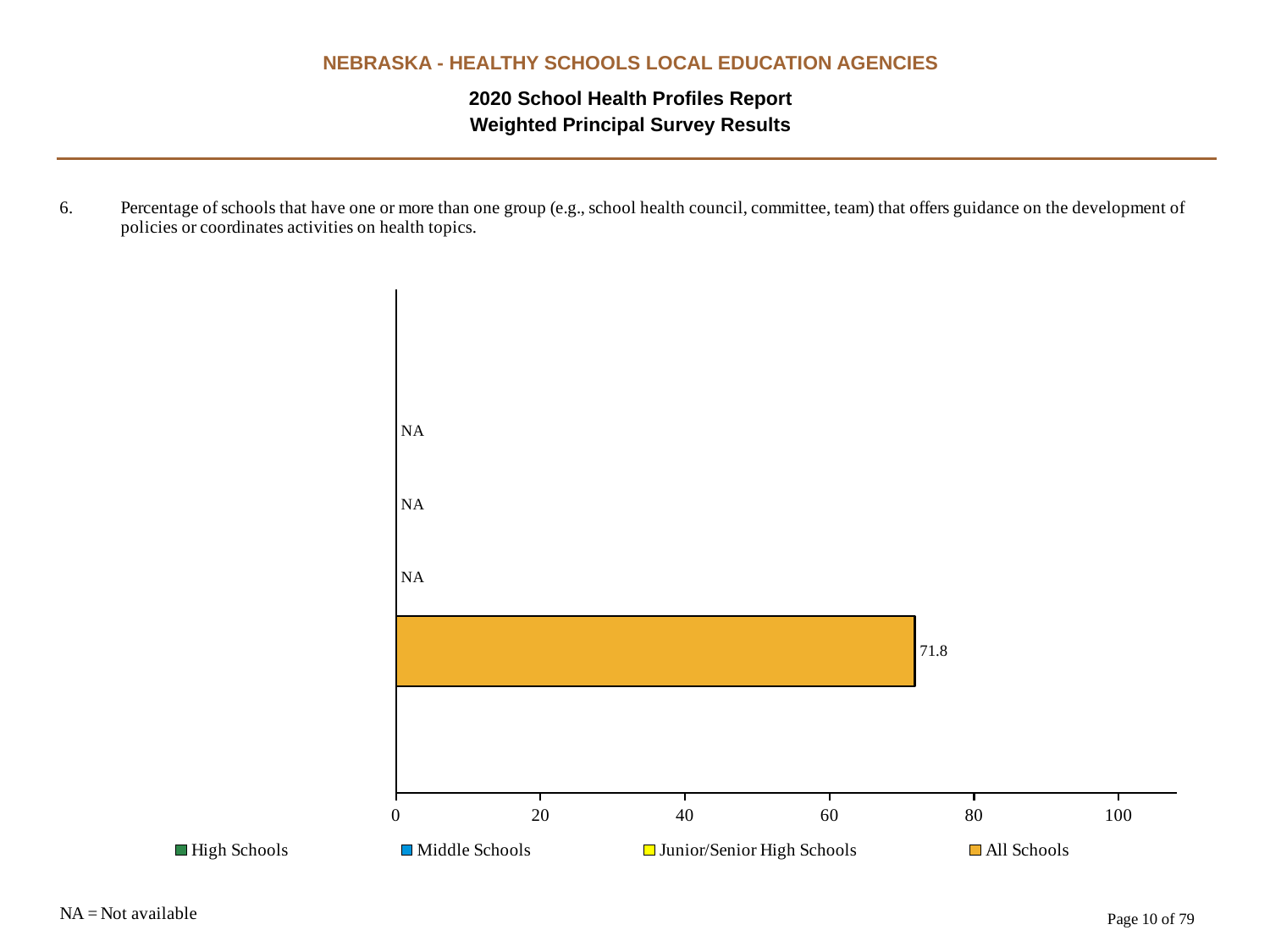
What kind of chart is shown on the slide? bar chart What value is shown for Junior/Senior High Schools? NA How many categories have a numeric value plotted as a bar? 1 Is the value for All Schools greater or less than 60? greater How many series does the legend list? 4 Is the value for All Schools greater or less than 80? less What value is shown for High Schools? NA What value is shown for Middle Schools? NA Which series does the legend list first? High Schools What is the value shown for All Schools? 71.8 According to the note on the slide, what does NA stand for? Not available